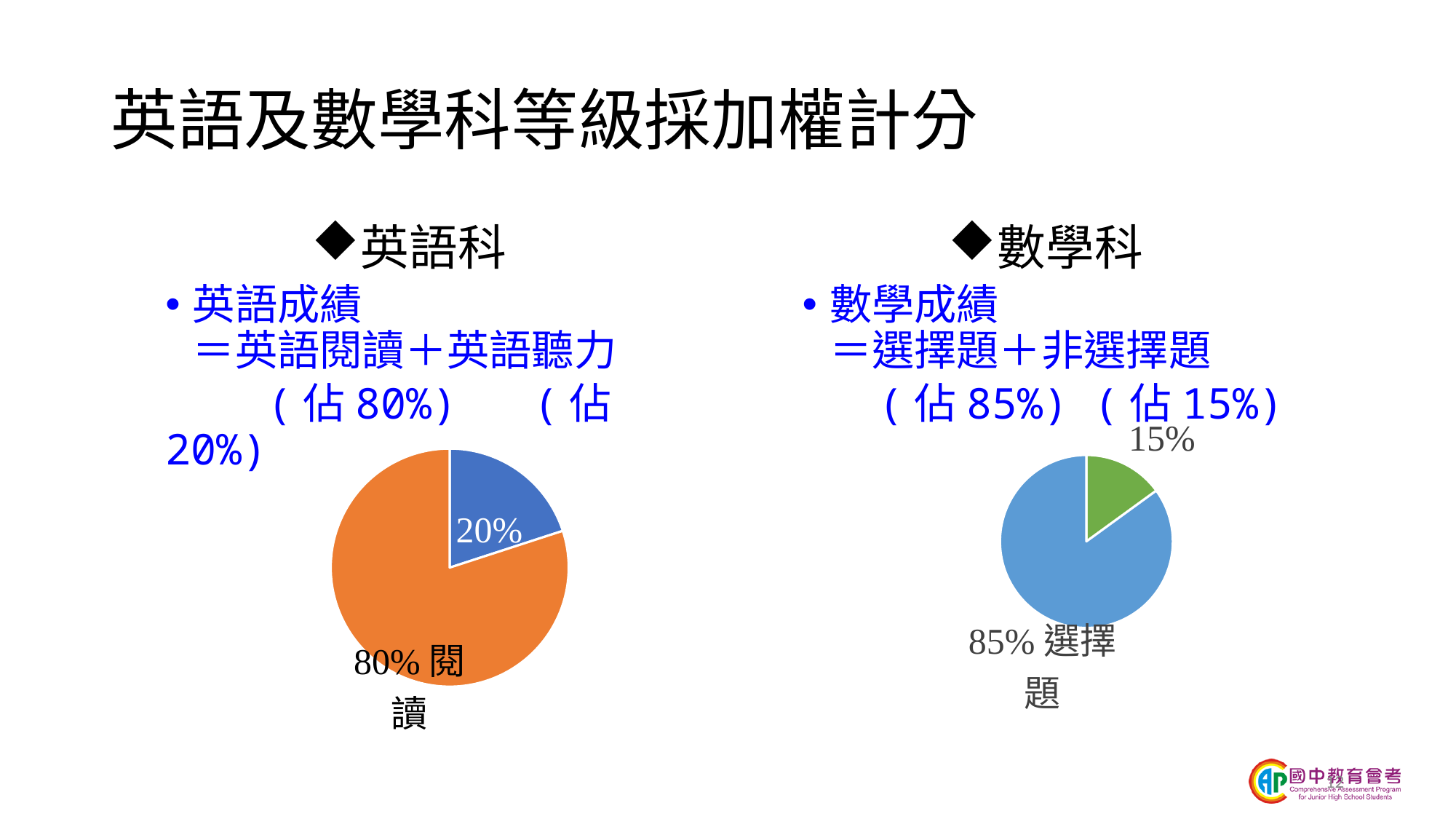
In the right pie chart (數學科), which slice is the smallest? 15% (green slice) What type of chart is shown under 英語科 on the left of the slide? pie chart In the left pie chart (英語科), what share does the 閱讀 slice have? 80% In the left pie chart (英語科), what is the difference between the 80% slice and the 20% slice? 60% In the right pie chart (數學科), what is the difference between the 85% slice and the 15% slice? 70% In the left pie chart (英語科), which slice is the largest? 閱讀 (80%) What type of chart is shown under 數學科 on the right of the slide? pie chart In the left pie chart (英語科), what share does the blue slice have? 20% How many slices does the left pie chart (英語科) have? 2 In the right pie chart (數學科), what share does the green slice have? 15% In the left pie chart (英語科), what colour is the 閱讀 slice? orange